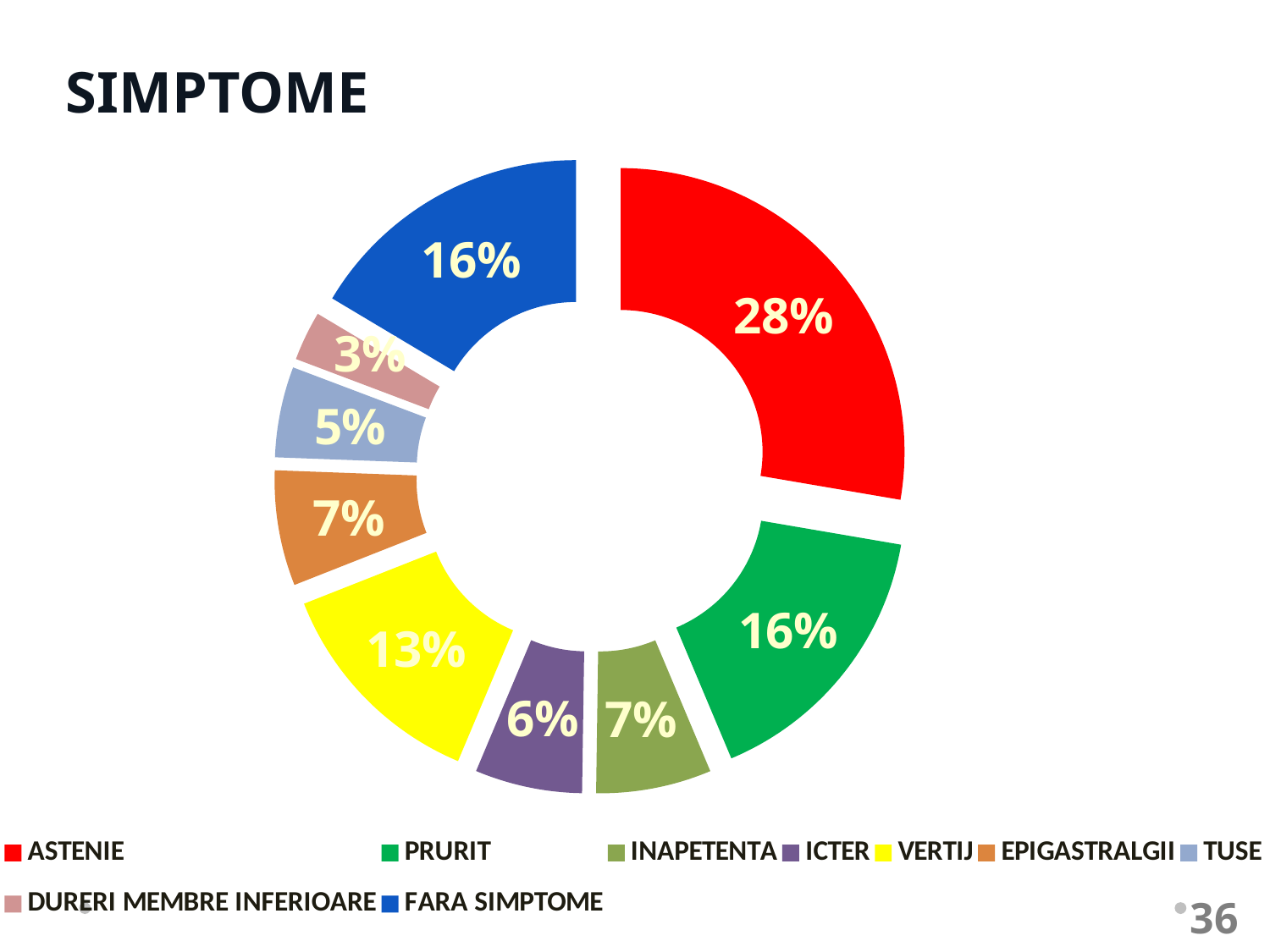
What is the value shown for VERTIJ? 13% How many categories does the chart show? 9 Which is larger, the share for VERTIJ or the share for EPIGASTRALGII? VERTIJ What colour is the slice for FARA SIMPTOME? blue Which category has the largest share of the chart? ASTENIE What is the difference between the shares of ASTENIE and PRURIT? 12% What is the value shown for DURERI MEMBRE INFERIOARE? 3% What kind of chart is shown on the slide? doughnut chart Which category has the smallest share of the chart? DURERI MEMBRE INFERIOARE What is the value shown for TUSE? 5% What percentage of the chart does ASTENIE represent? 28% What is the title of the chart? SIMPTOME